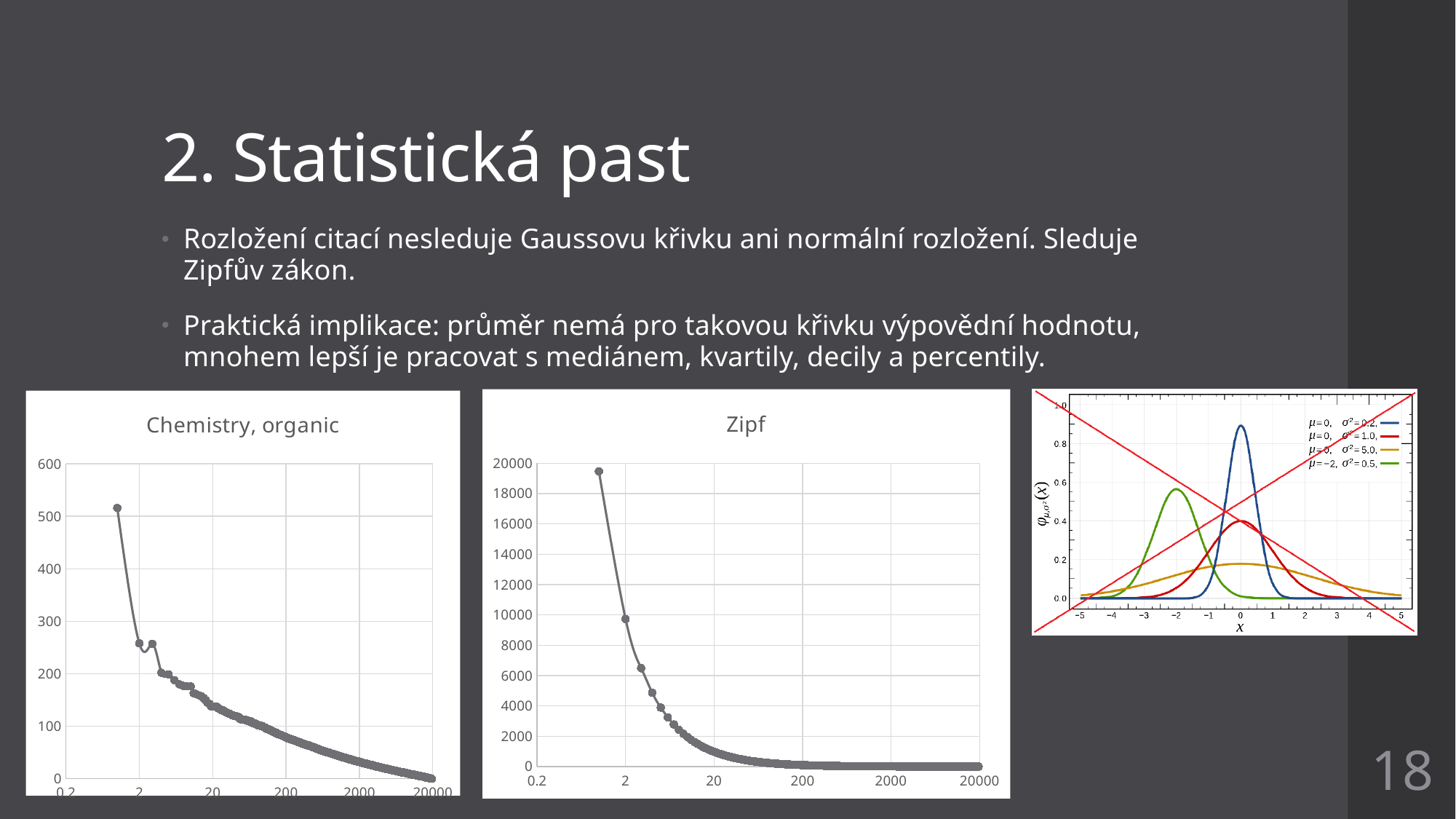
In the Chemistry, organic chart, do the values rise or fall as you move along the x axis? fall In the Zipf chart, which point has the highest value, the leftmost point or the rightmost point? the leftmost point What is the title of the middle chart? Zipf What is the highest value shown on the y axis of the Zipf chart? 20000 What is the title of the left chart? Chemistry, organic In the Zipf chart, do the values rise or fall as you move along the x axis? fall In the Chemistry, organic chart, is the value of the first (leftmost) point greater or less than 500? greater In the Chemistry, organic chart, is the value at x = 20 greater or less than 200? less What kind of chart is the Zipf chart? line chart In the Chemistry, organic chart, is the value of the first (leftmost) point greater or less than 600? less